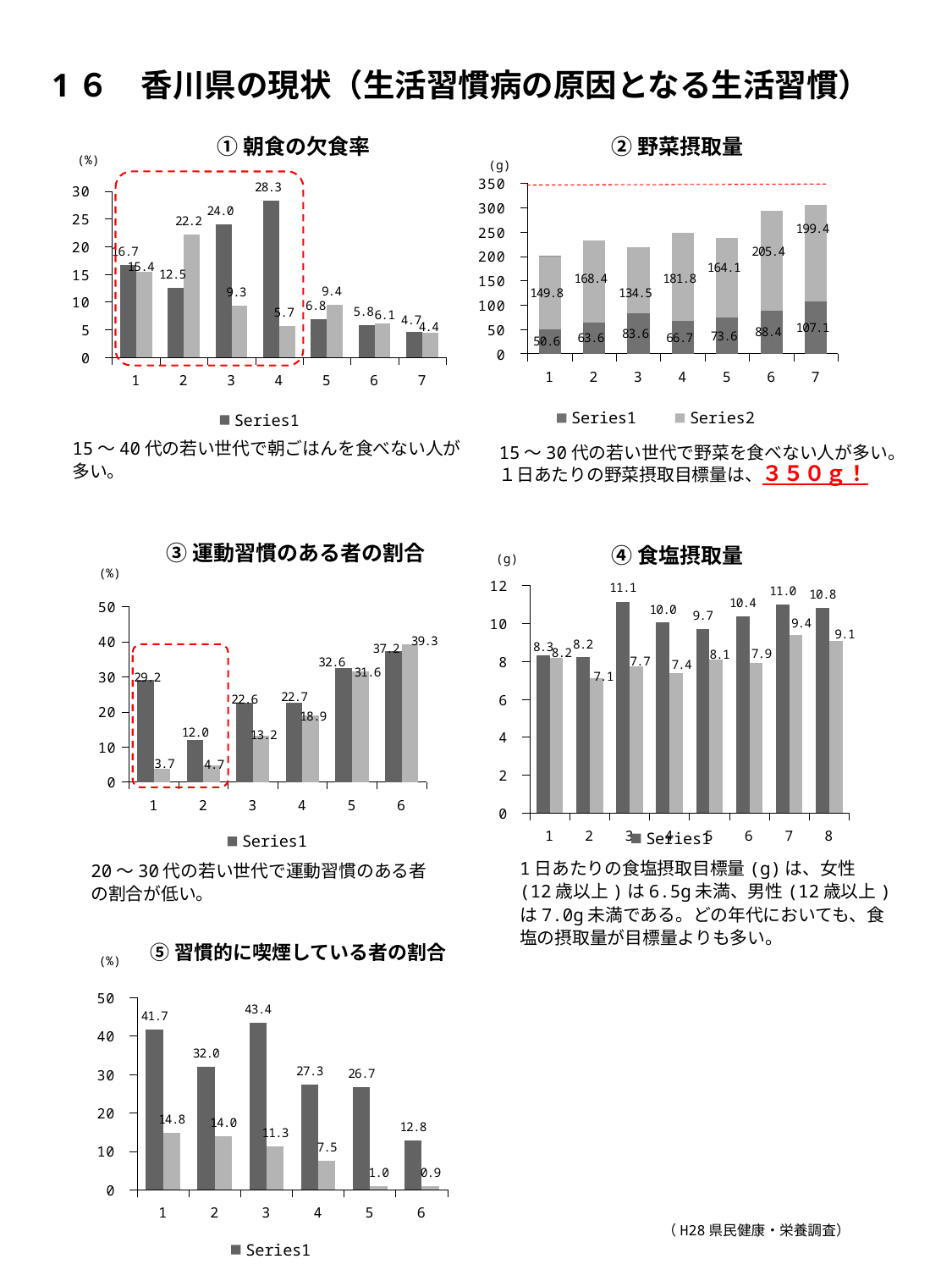
In the chart titled ① 朝食の欠食率, how many categories are shown on the x axis? 7 In the chart titled ④ 食塩摂取量, what is the difference between the dark bar and the light bar for category 3? 3.4 In the chart titled ② 野菜摂取量, how many series does the legend list? 2 In the chart titled ⑤ 習慣的に喫煙している者の割合, which is larger, the dark bar for category 1 or the dark bar for category 3? category 3 In the chart titled ③ 運動習慣のある者の割合, what is the value of the light bar for category 1? 3.7 In the chart titled ① 朝食の欠食率, what is the value of the dark bar for category 4? 28.3 In the chart titled ③ 運動習慣のある者の割合, which category has the lowest dark bar? 2 In the chart titled ① 朝食の欠食率, which category has the highest dark bar? 4 What kind of chart is the chart titled ⑤ 習慣的に喫煙している者の割合? bar chart In the chart titled ② 野菜摂取量, what is the Series2 value for category 6? 205.4 In the chart titled ④ 食塩摂取量, is the dark bar for category 7 greater or less than 10? greater In the chart titled ② 野菜摂取量, what is the total of the stacked bar for category 7? 306.5